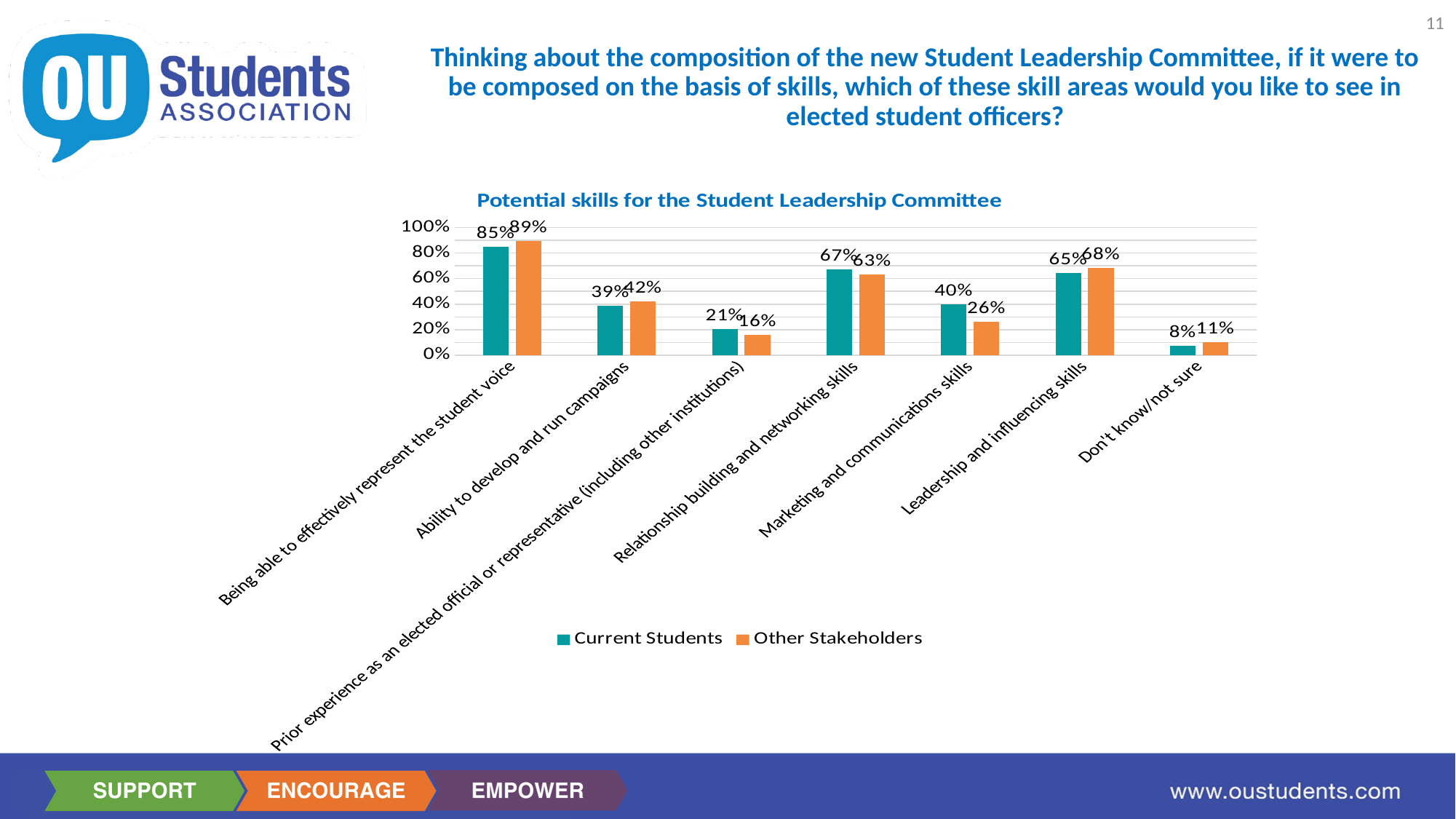
For 'Relationship building and networking skills', which series has the larger value, Current Students or Other Stakeholders? Current Students How many series does the legend list? 2 What is the Current Students value for 'Being able to effectively represent the student voice'? 85% What is the title of the chart? Potential skills for the Student Leadership Committee What is the difference between the Current Students and Other Stakeholders values for 'Marketing and communications skills'? 14% Which category has the lowest Current Students value? Don't know/not sure Is the Other Stakeholders value for 'Leadership and influencing skills' greater or less than 60%? greater What kind of chart is shown on the slide? Bar chart What is the Current Students value for 'Prior experience as an elected official or representative (including other institutions)'? 21% How many skill categories are shown on the x axis? 7 Which category has the highest Other Stakeholders value? Being able to effectively represent the student voice What is the Other Stakeholders value for 'Marketing and communications skills'? 26%